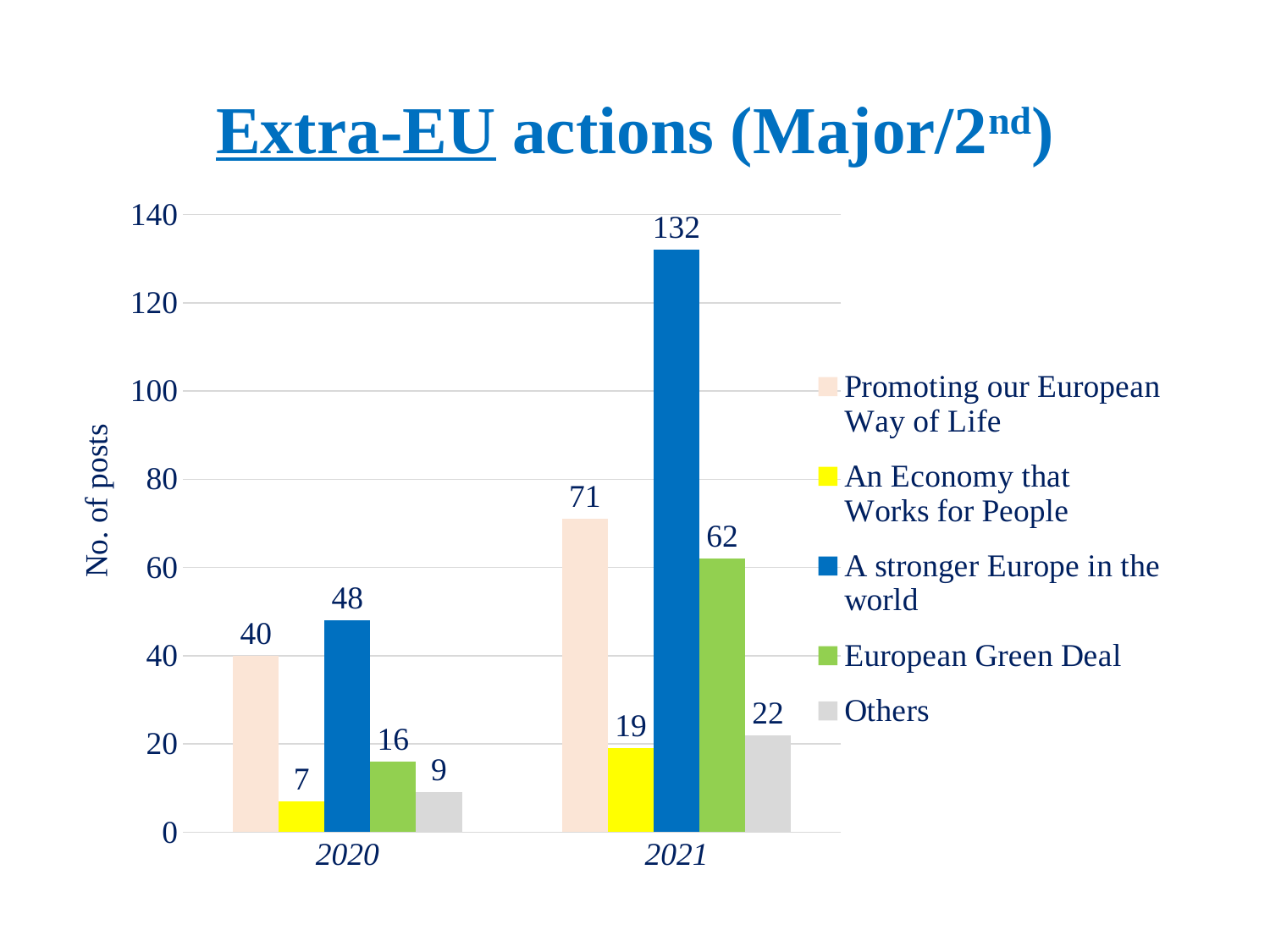
What kind of chart is shown on the slide? Bar chart Which is larger: 'European Green Deal' in 2021 or 'Promoting our European Way of Life' in 2021? Promoting our European Way of Life Which series has the lowest value in 2020? An Economy that Works for People What is the value for 'An Economy that Works for People' in 2021? 19 What is the difference between the 'A stronger Europe in the world' values for 2021 and 2020? 84 How many categories are shown on the x axis? 2 What is the label of the y axis? No. of posts Does the value for 'Others' rise or fall from 2020 to 2021? Rise What is the value for 'Promoting our European Way of Life' in 2020? 40 What is the value for 'A stronger Europe in the world' in 2021? 132 Which series has the highest value in 2021? A stronger Europe in the world How many series does the legend list? 5